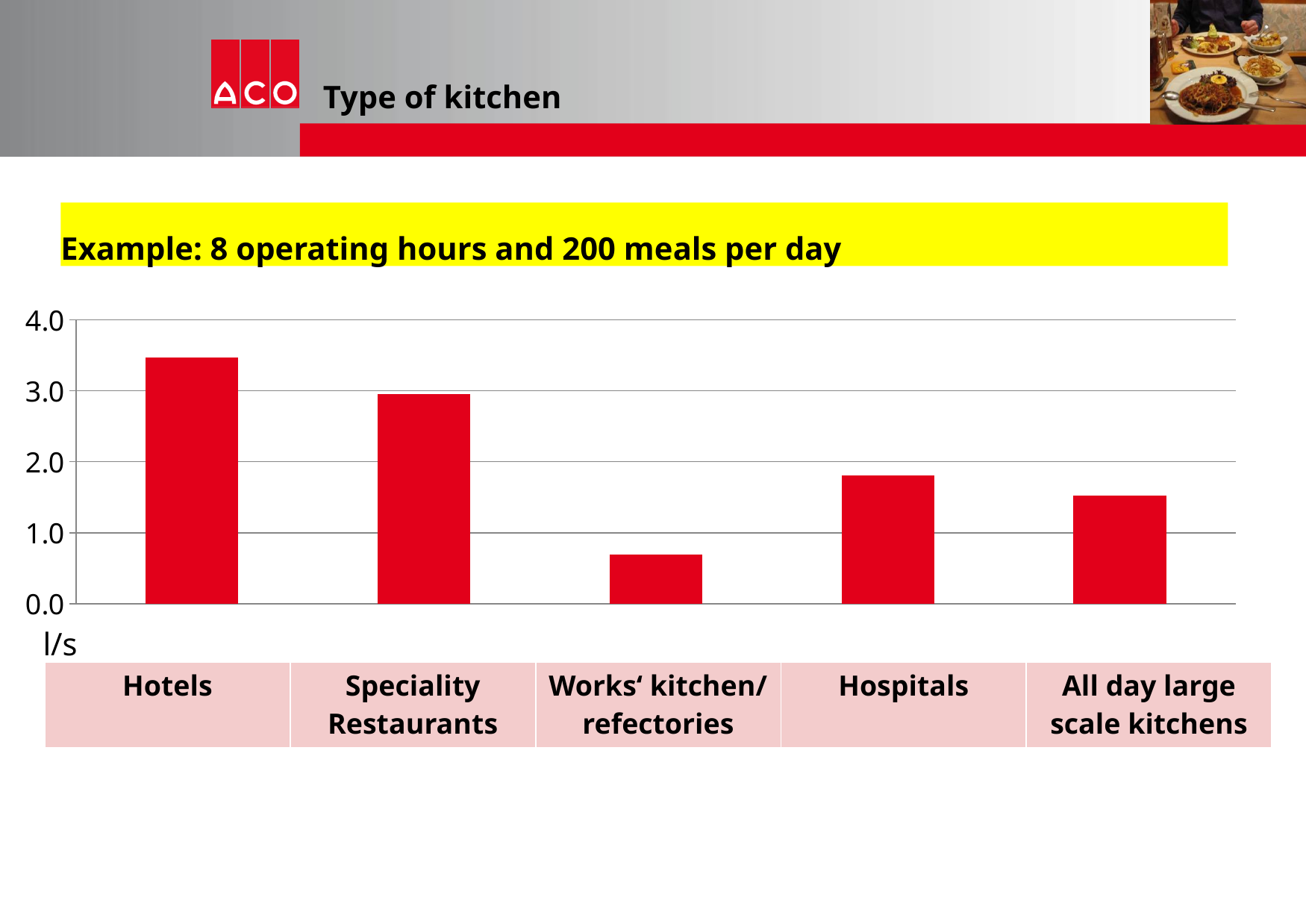
Which has the larger value, Hotels or Speciality Restaurants? Hotels Is the value for Speciality Restaurants greater or less than 2.0? greater How many types of kitchen are shown on the chart? 5 Is the value for Works' kitchen/ refectories greater or less than 1.0? less Which type of kitchen has the lowest value? Works' kitchen/ refectories Is the value for Hospitals greater or less than 2.0? less What kind of chart is shown on the slide? bar chart What unit is shown on the chart's vertical axis? l/s Which type of kitchen has the highest value? Hotels Which has the larger value, Hospitals or All day large scale kitchens? Hospitals